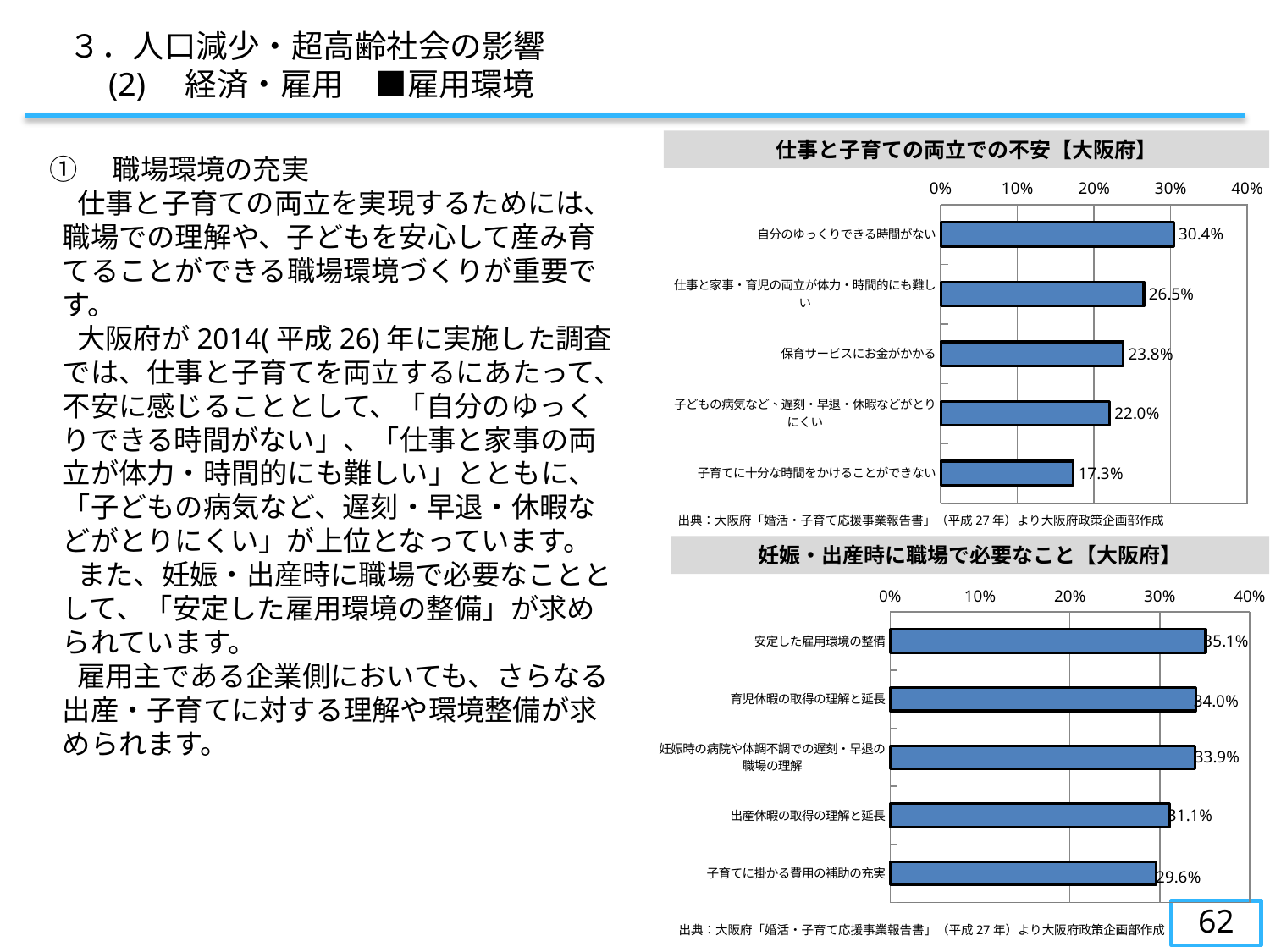
In the chart titled 妊娠・出産時に職場で必要なこと【大阪府】, which is larger: 出産休暇の取得の理解と延長 or 子育てに掛かる費用の補助の充実? 出産休暇の取得の理解と延長 In the chart titled 妊娠・出産時に職場で必要なこと【大阪府】, which category has the highest value? 安定した雇用環境の整備 What type of chart is the chart titled 妊娠・出産時に職場で必要なこと【大阪府】? Bar chart In the chart titled 仕事と子育ての両立での不安【大阪府】, how many categories are shown? 5 In the chart titled 仕事と子育ての両立での不安【大阪府】, what is the value for 自分のゆっくりできる時間がない? 30.4% In the chart titled 妊娠・出産時に職場で必要なこと【大阪府】, what is the value for 子育てに掛かる費用の補助の充実? 29.6% In the chart titled 仕事と子育ての両立での不安【大阪府】, what is the difference between 自分のゆっくりできる時間がない and 子育てに十分な時間をかけることができない? 13.1% In the chart titled 妊娠・出産時に職場で必要なこと【大阪府】, what is the difference between 安定した雇用環境の整備 and 出産休暇の取得の理解と延長? 4.0% In the chart titled 仕事と子育ての両立での不安【大阪府】, which category has the lowest value? 子育てに十分な時間をかけることができない In the chart titled 妊娠・出産時に職場で必要なこと【大阪府】, what is the value for 安定した雇用環境の整備? 35.1% In the chart titled 仕事と子育ての両立での不安【大阪府】, what is the value for 保育サービスにお金がかかる? 23.8% In the chart titled 仕事と子育ての両立での不安【大阪府】, is the value for 仕事と家事・育児の両立が体力・時間的にも難しい greater or less than 20%? greater